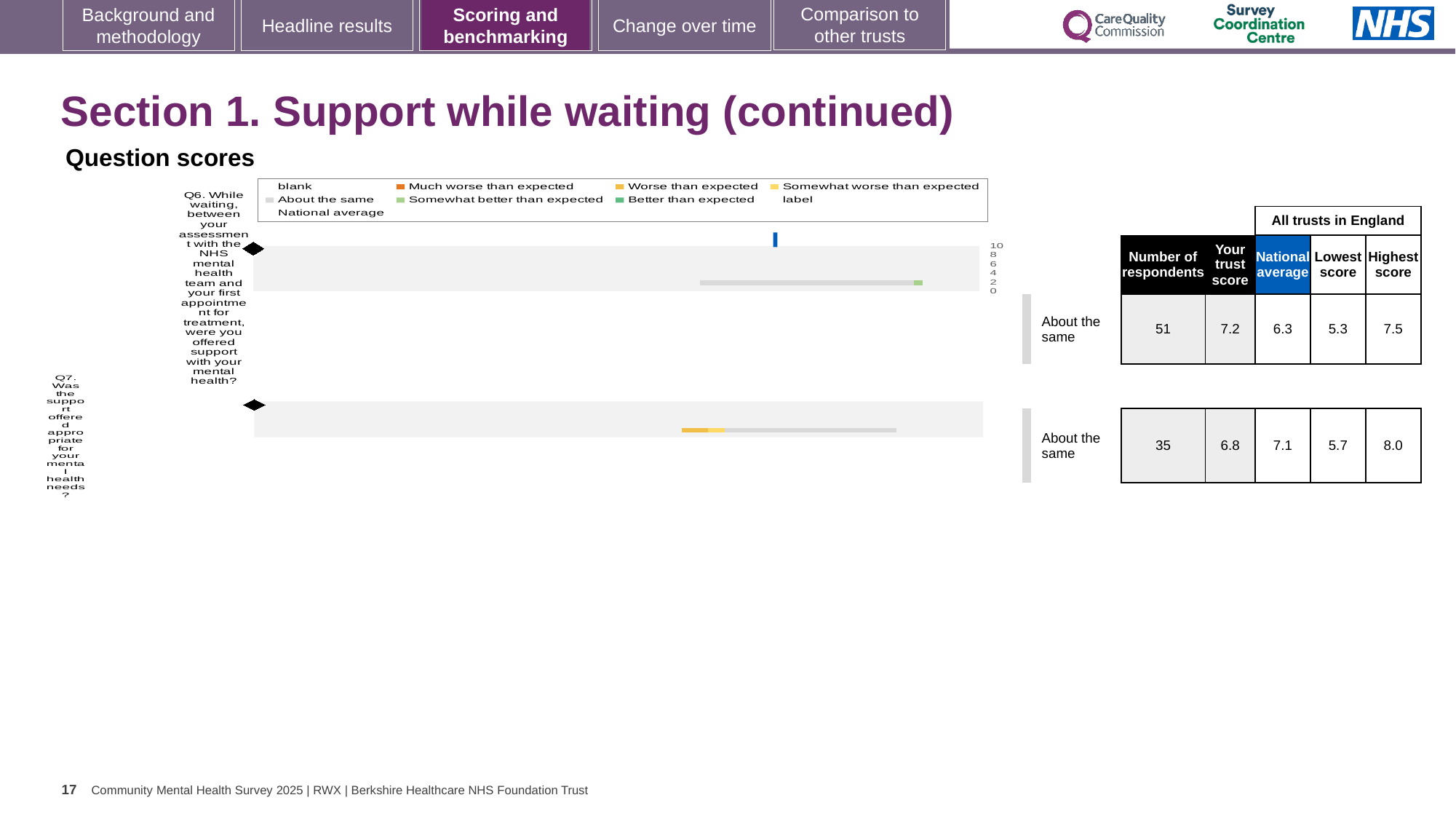
How many questions are plotted in the question scores chart? 2 What is the national average score for Q7? 7.1 What is the difference between the highest score and the lowest score for Q7? 2.3 What is the trust score for Q6 (support with mental health while waiting)? 7.2 For Q6, which is larger: the trust score or the national average? the trust score What is the national average score for Q6? 6.3 For Q7, which is larger: the trust score or the national average? the national average What kind of chart is used to show the question scores on this slide? bar chart Which question has the higher trust score, Q6 or Q7? Q6 What is the trust score for Q7 (was the support offered appropriate)? 6.8 What is the difference between the highest score and the lowest score for Q6? 2.2 What benchmark category is shown for Q7? About the same